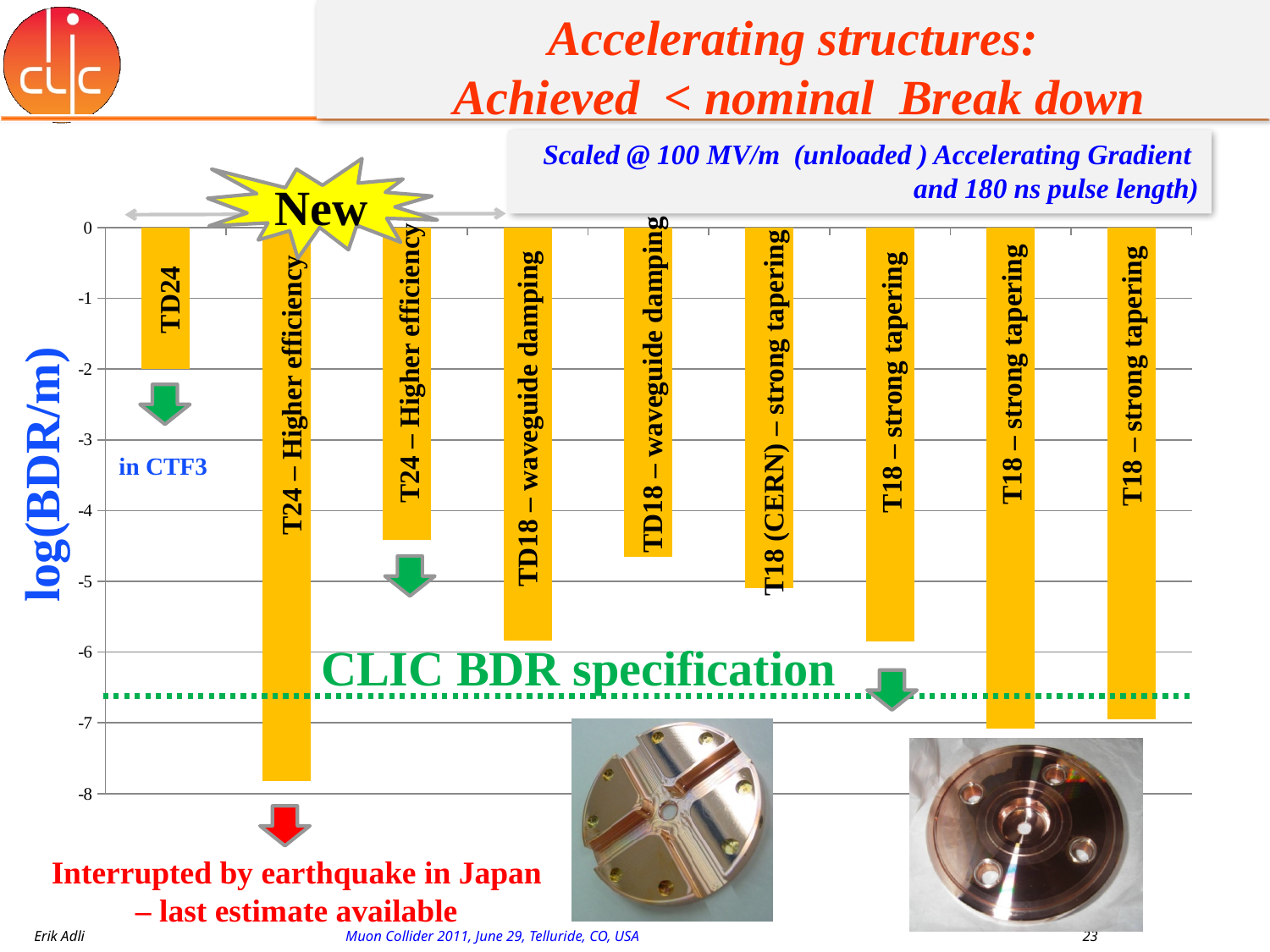
Which has the larger (less negative) value: TD24 or T18 (CERN) – strong tapering? TD24 What kind of chart is shown on the slide? bar chart Which bar has the highest (least negative) value in the chart? TD24 What is the label on the y axis of the chart? log(BDR/m) Is the value for the third bar, T24 – Higher efficiency, greater or less than -5? greater Is the value for TD24 greater or less than -3? greater Is the value for the second TD18 – waveguide damping bar (fifth from the left) greater or less than -4? less What does the dotted green horizontal line in the chart represent? CLIC BDR specification Which bar reaches the lowest (most negative) value in the chart? T24 – Higher efficiency (the second bar, marked New) How many bars are plotted in the chart? 9